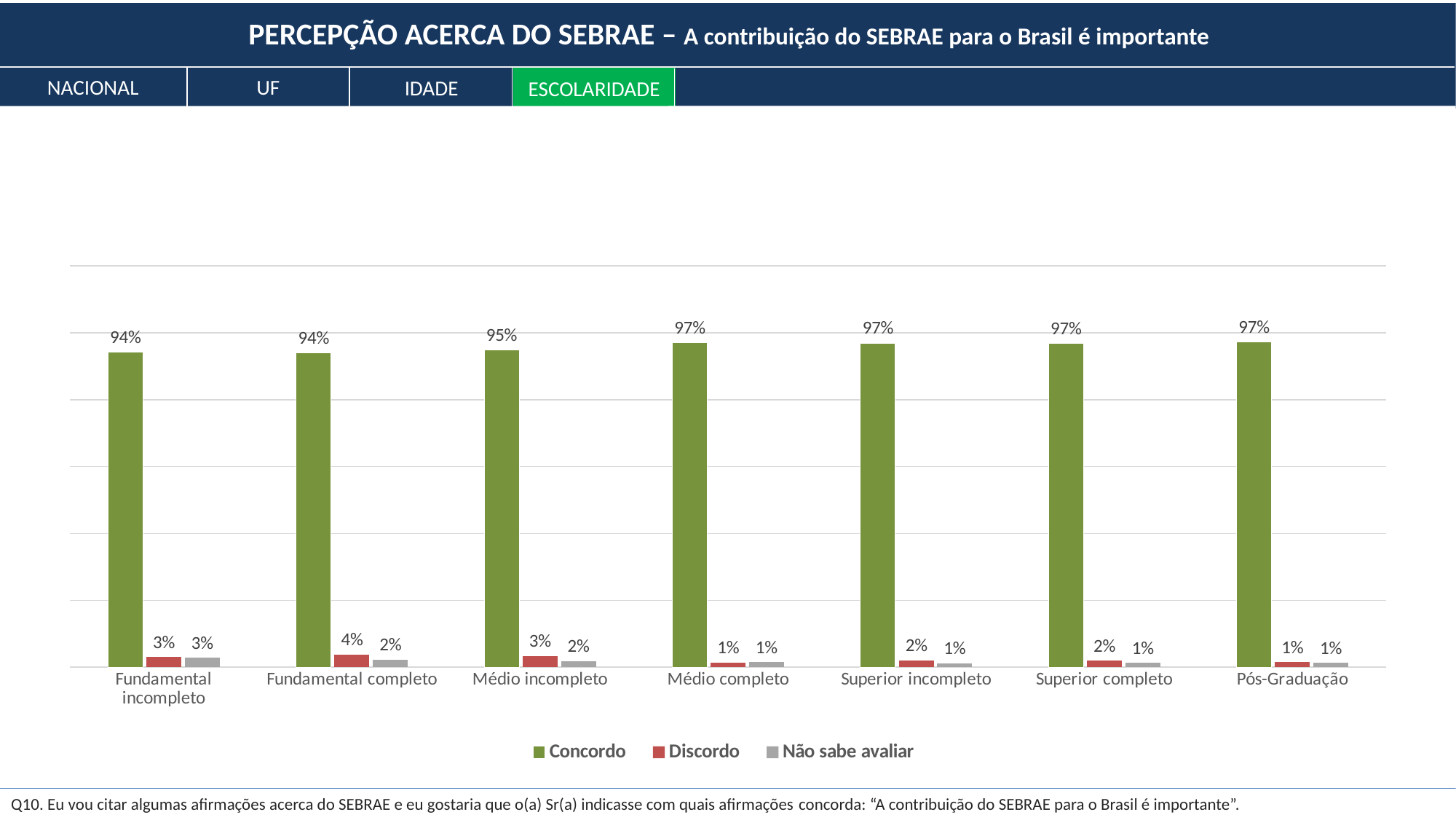
How many series does the legend list? 3 What is the Concordo value for Pós-Graduação? 97% What is the Concordo value for Fundamental incompleto? 94% What is the difference between the Concordo values for Pós-Graduação and Fundamental incompleto? 3 percentage points What is the Não sabe avaliar value for Médio incompleto? 2% What is the Discordo value for Fundamental completo? 4% Which category has the highest Não sabe avaliar value? Fundamental incompleto Which category has the highest Discordo value? Fundamental completo How many education categories are shown on the x axis? 7 What kind of chart is shown on the slide? Bar chart Which is larger: the Discordo value for Fundamental completo or for Médio completo? Fundamental completo Do the Concordo values generally rise or fall from Fundamental incompleto to Pós-Graduação? Rise